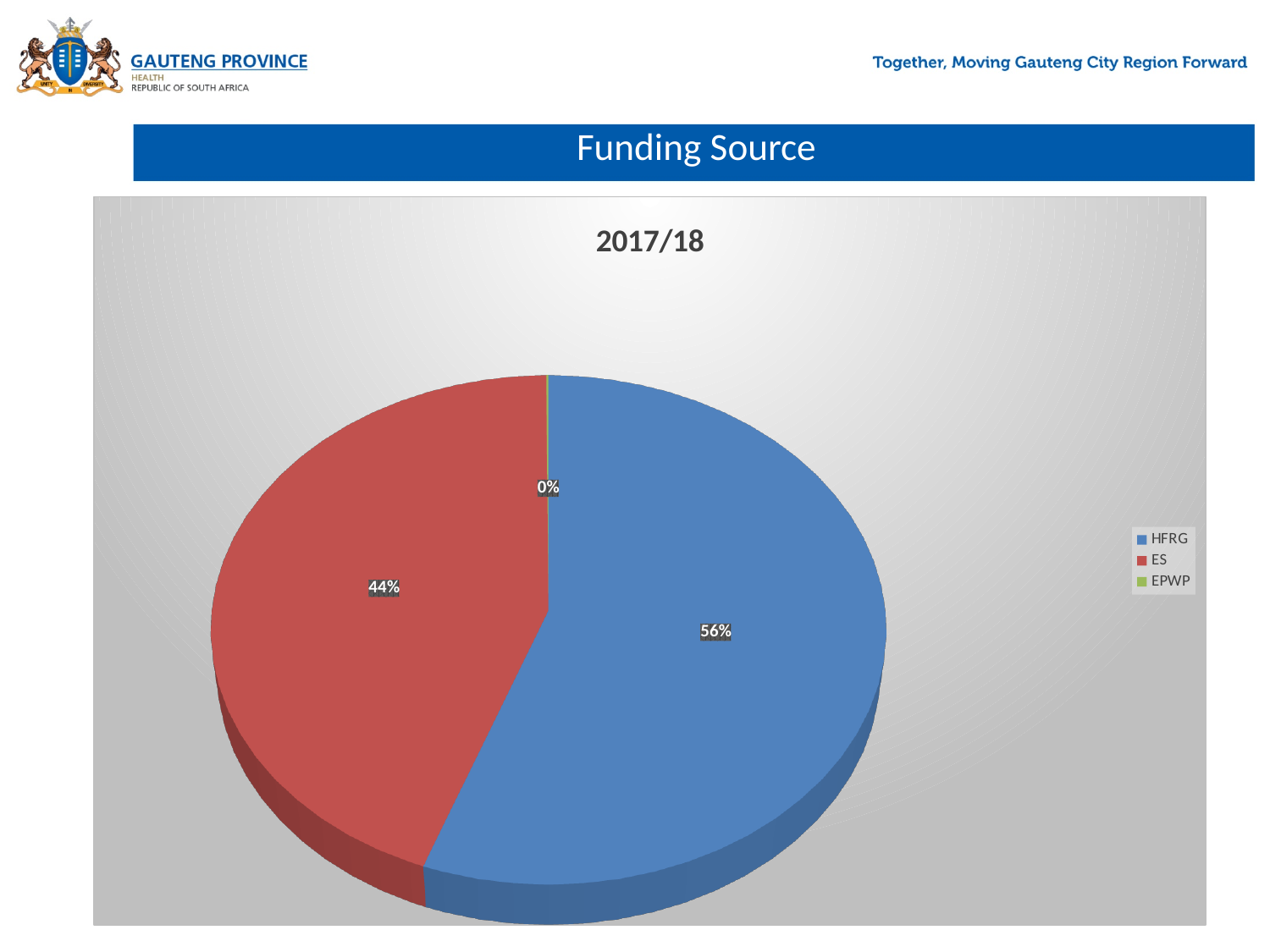
What share of the pie does ES represent? 44% Which funding source has the largest share of the pie? HFRG What is the title of the chart? 2017/18 What type of chart is shown on the slide? Pie chart Is the share for ES greater or less than 50%? less Which is larger, the share for HFRG or the share for ES? HFRG Which colour represents ES in the chart? Red What share of the pie does HFRG represent? 56% What percentage is shown for EPWP? 0% What is the difference in percentage points between the HFRG and ES shares? 12 Which funding source has the smallest share of the pie? EPWP How many categories does the legend list? 3